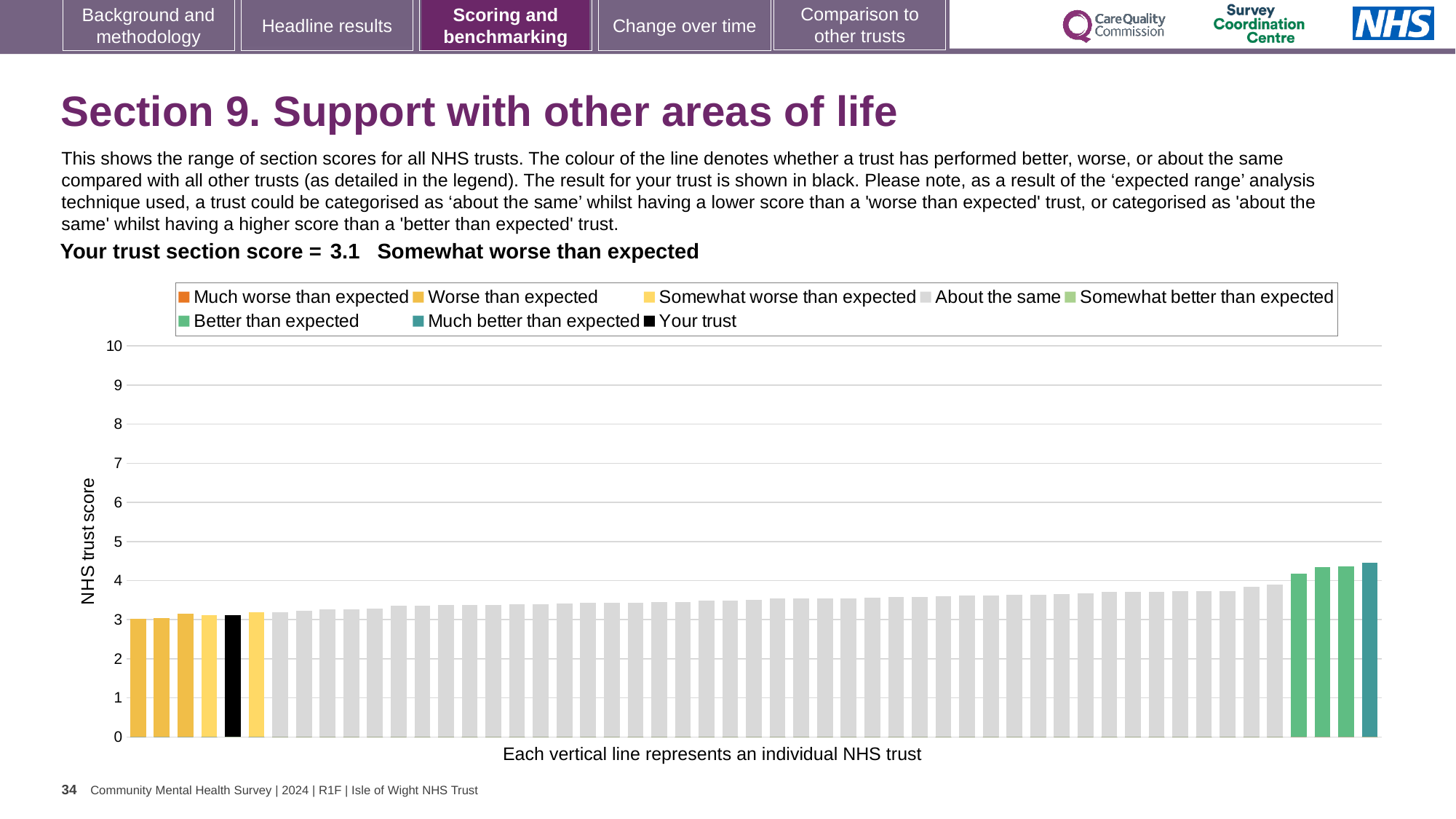
Is the value of the tallest bar in the chart greater or less than 4? greater What is the section score for your trust? 3.1 Do the bar values rise or fall from left to right along the x axis? rise Is the value of the black 'Your trust' bar greater or less than 4? less Which performance category is your trust placed in for this section? Somewhat worse than expected Is the value of the shortest bar in the chart greater or less than 2? greater What is the label on the vertical axis of the chart? NHS trust score How many entries does the chart legend list? 8 Is the black 'Your trust' bar higher or lower than the teal 'Much better than expected' bar? lower What kind of chart is shown on the slide? bar chart Which legend category does the tallest bar (the teal bar at the far right) belong to? Much better than expected